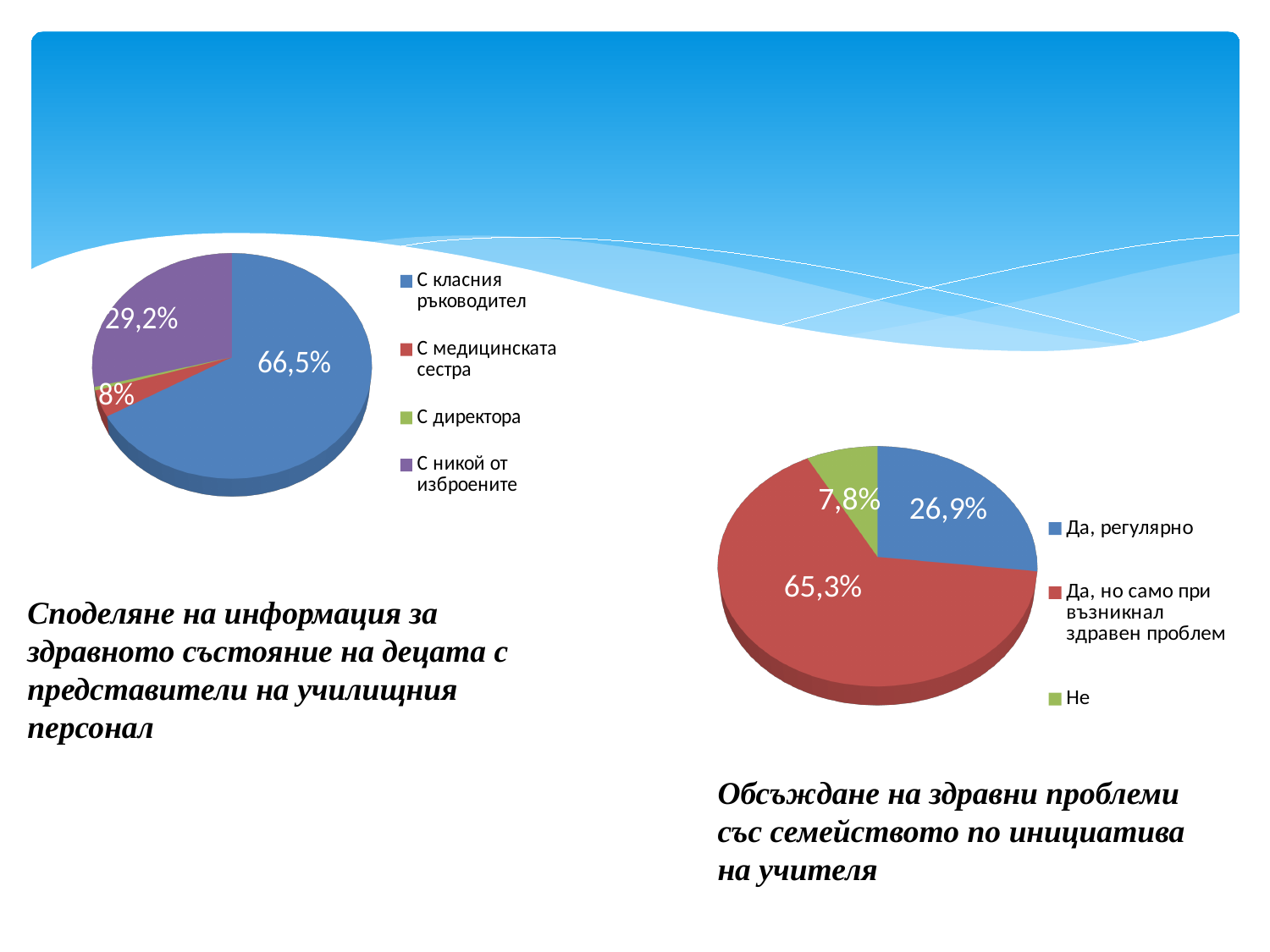
In the left pie chart (Споделяне на информация за здравното състояние на децата), which category has the smallest slice? С директора In the right pie chart (Обсъждане на здравни проблеми със семейството), what is the difference between the shares for 'Да, но само при възникнал здравен проблем' and 'Да, регулярно'? 38,4% How many categories does the legend of the right pie chart (Обсъждане на здравни проблеми със семейството) list? 3 In the right pie chart (Обсъждане на здравни проблеми със семейството), which is larger: the share for 'Да, регулярно' or the share for 'Не'? Да, регулярно In the right pie chart (Обсъждане на здравни проблеми със семейството), what share is labelled for 'Не'? 7,8% In the left pie chart (Споделяне на информация за здравното състояние на децата), which category has the largest slice? С класния ръководител What type of chart is used for 'Обсъждане на здравни проблеми със семейството по инициатива на учителя'? Pie chart In the right pie chart (Обсъждане на здравни проблеми със семейството), which category has the largest slice? Да, но само при възникнал здравен проблем In the left pie chart (Споделяне на информация за здравното състояние на децата), what share is labelled for 'С класния ръководител'? 66,5% In the right pie chart (Обсъждане на здравни проблеми със семейството), what share is labelled for 'Да, регулярно'? 26,9% How many categories does the legend of the left pie chart (Споделяне на информация за здравното състояние на децата) list? 4 In the left pie chart (Споделяне на информация за здравното състояние на децата), what share is labelled for 'С никой от изброените'? 29,2%